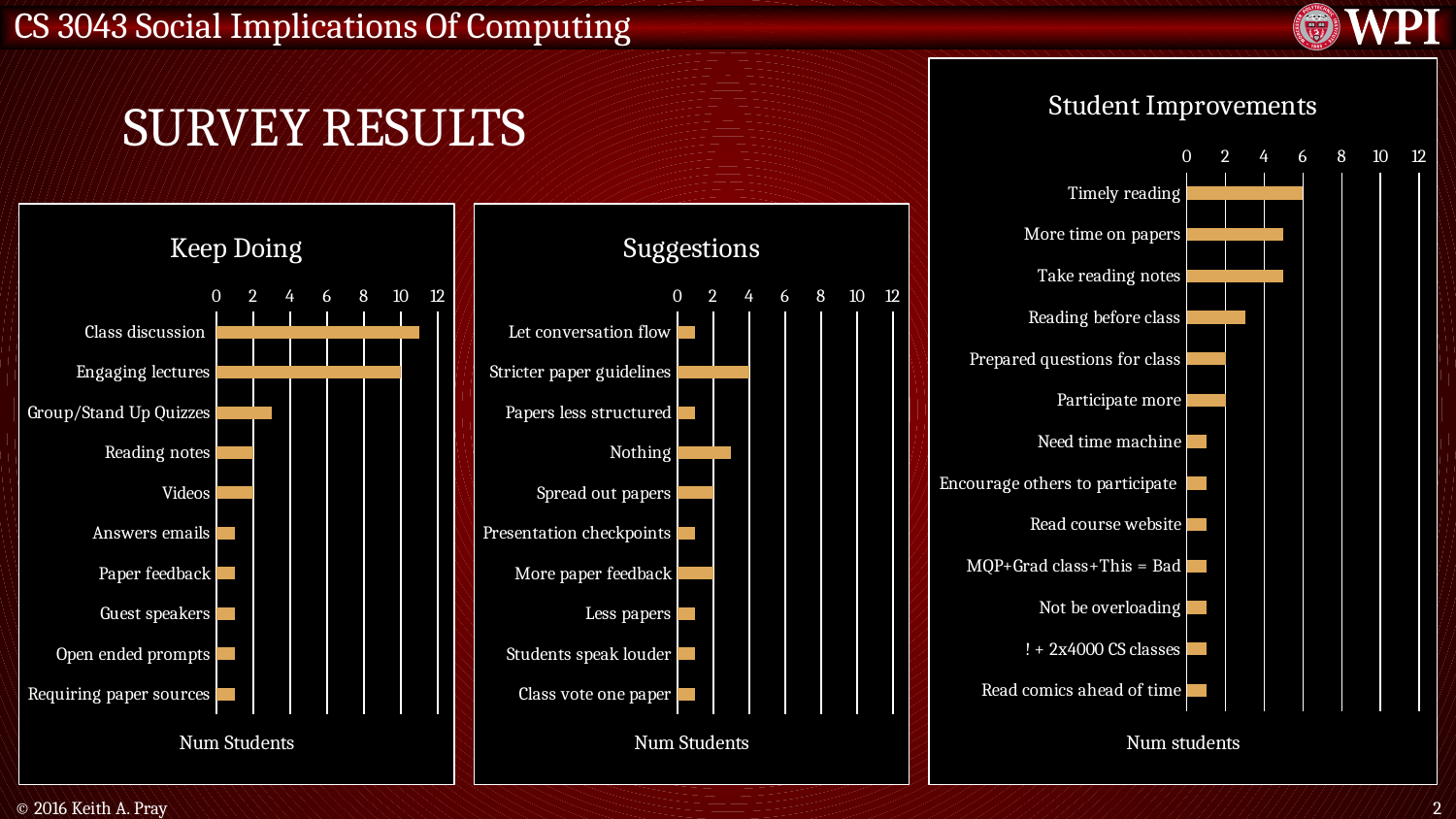
In the Keep Doing chart, which category has the highest value? Class discussion In the Suggestions chart, which is larger: Nothing or Let conversation flow? Nothing In the Keep Doing chart, which is larger: Engaging lectures or Reading notes? Engaging lectures In the Suggestions chart, which category has the highest value? Stricter paper guidelines In the Keep Doing chart, is the value for Group/Stand Up Quizzes greater or less than 4? less What kind of chart is the Keep Doing chart? bar chart How many categories are shown in the Student Improvements chart? 13 In the Suggestions chart, is the value for Nothing greater or less than 4? less How many categories are shown in the Keep Doing chart? 10 In the Keep Doing chart, is the value for Class discussion greater or less than 8? greater What is the x-axis label of the Student Improvements chart? Num students In the Student Improvements chart, which category has the highest value? Timely reading